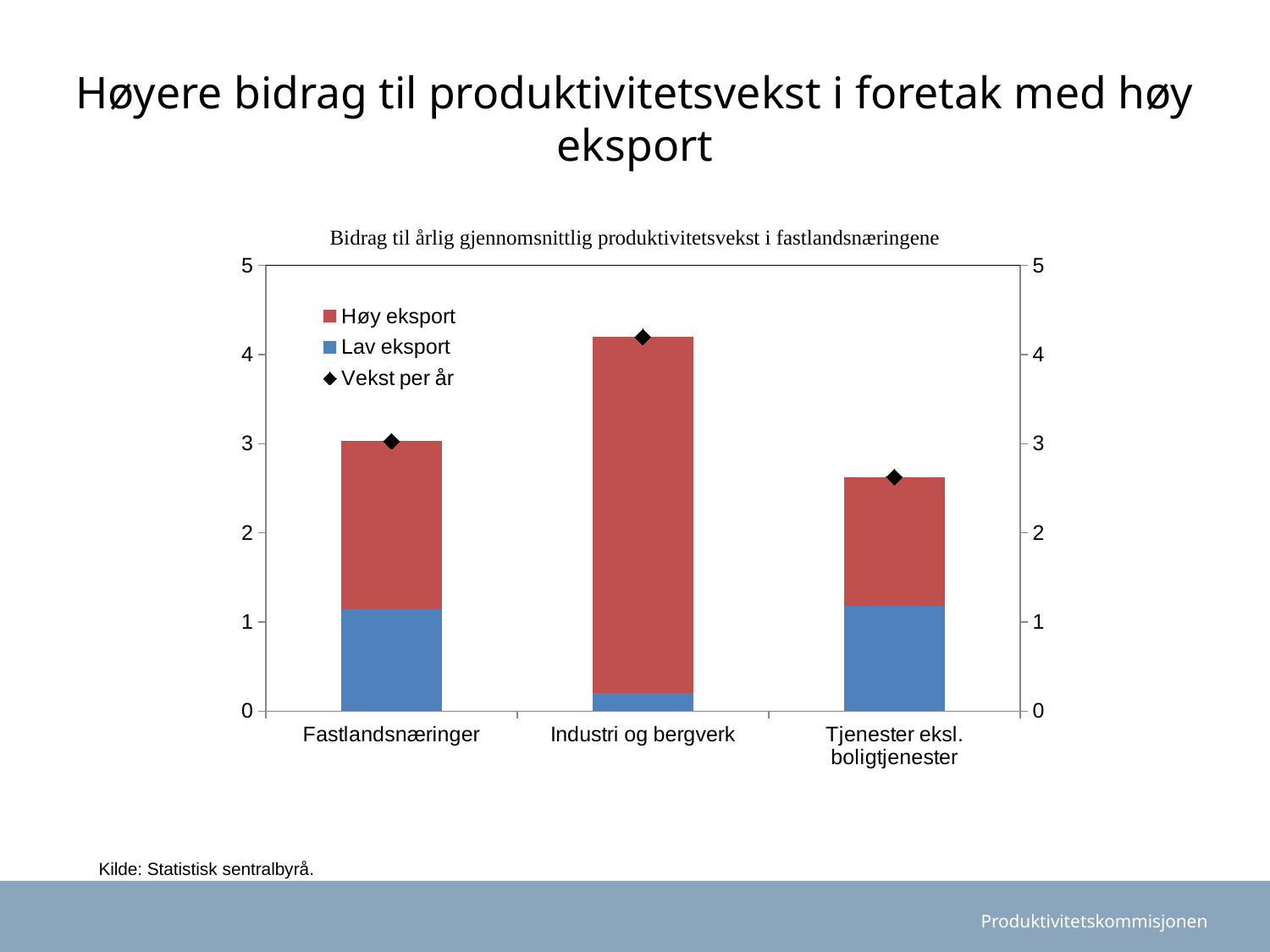
Is the total value for Tjenester eksl. boligtjenester greater or less than 3? less What kind of chart is shown on the slide? Stacked bar chart Which has the larger Lav eksport segment, Fastlandsnæringer or Industri og bergverk? Fastlandsnæringer How many series does the chart's legend list? 3 Which has the larger Høy eksport segment, Industri og bergverk or Tjenester eksl. boligtjenester? Industri og bergverk How many categories are shown on the x axis of the chart? 3 Is the Lav eksport value for Industri og bergverk greater or less than 1? less Which category has the smallest Lav eksport segment? Industri og bergverk What is the title of the chart? Bidrag til årlig gjennomsnittlig produktivitetsvekst i fastlandsnæringene Is the total value for Industri og bergverk greater or less than 4? greater Which category has the highest total bar? Industri og bergverk Which category has the lowest total bar? Tjenester eksl. boligtjenester